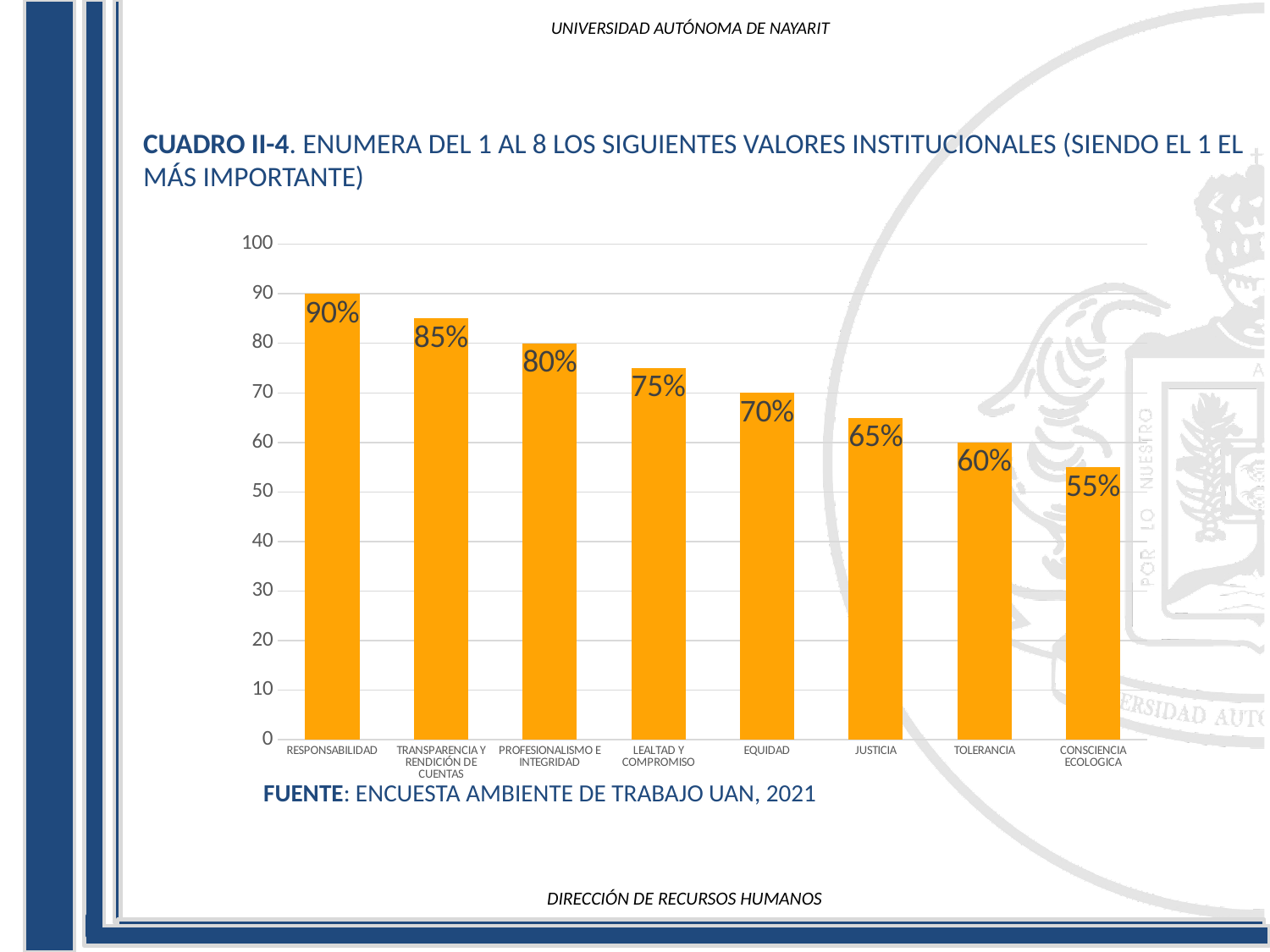
What is the value for CONSCIENCIA ECOLOGICA? 55% Which category has the lowest value? CONSCIENCIA ECOLOGICA Which is larger, the value for EQUIDAD or the value for JUSTICIA? EQUIDAD What is the value for JUSTICIA? 65% How many categories are shown on the x axis? 8 Do the values rise or fall from left to right along the x axis? fall Is the value for LEALTAD Y COMPROMISO greater or less than 70? greater What kind of chart is shown on the slide? bar chart What is the value for RESPONSABILIDAD? 90% What is the difference between the values for RESPONSABILIDAD and TOLERANCIA? 30% What source is cited below the chart? ENCUESTA AMBIENTE DE TRABAJO UAN, 2021 Which category has the highest value? RESPONSABILIDAD